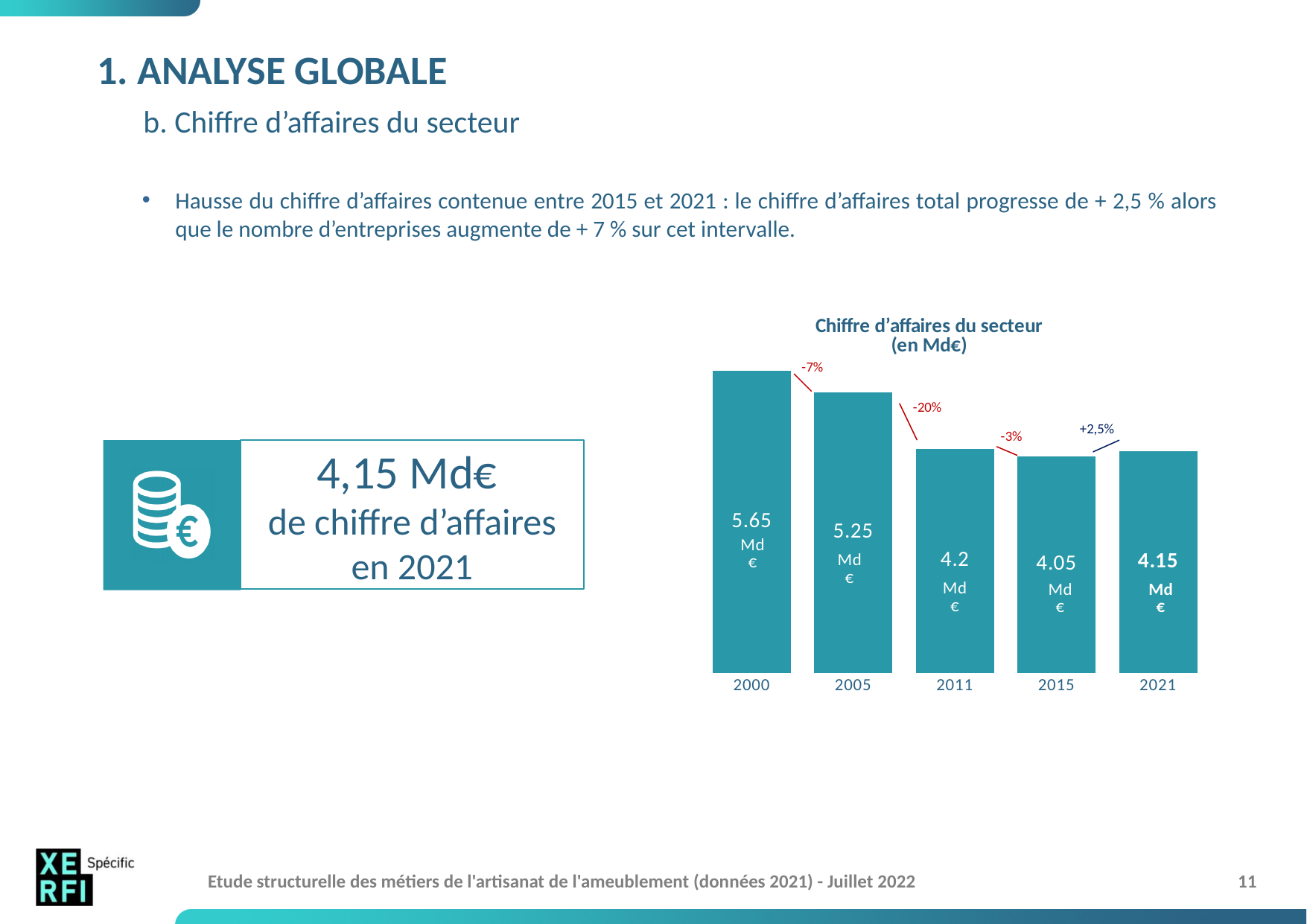
Which year has the highest value in the chart? 2000 What is the difference between the values for 2000 and 2005? 0.4 Md€ What is the value for 2021 in the chart? 4.15 Md€ Which year has the lowest value in the chart? 2015 What percentage change is shown between 2005 and 2011? -20% What is the value for 2000 in the chart 'Chiffre d'affaires du secteur (en Md€)'? 5.65 Md€ What kind of chart is shown on the slide? Bar chart How many years are shown in the chart? 5 What percentage change is shown between 2015 and 2021? +2,5% What is the value for 2011 in the chart? 4.2 Md€ Which is larger, the value for 2015 or the value for 2021? 2021 What is the difference between the values for 2005 and 2011? 1.05 Md€